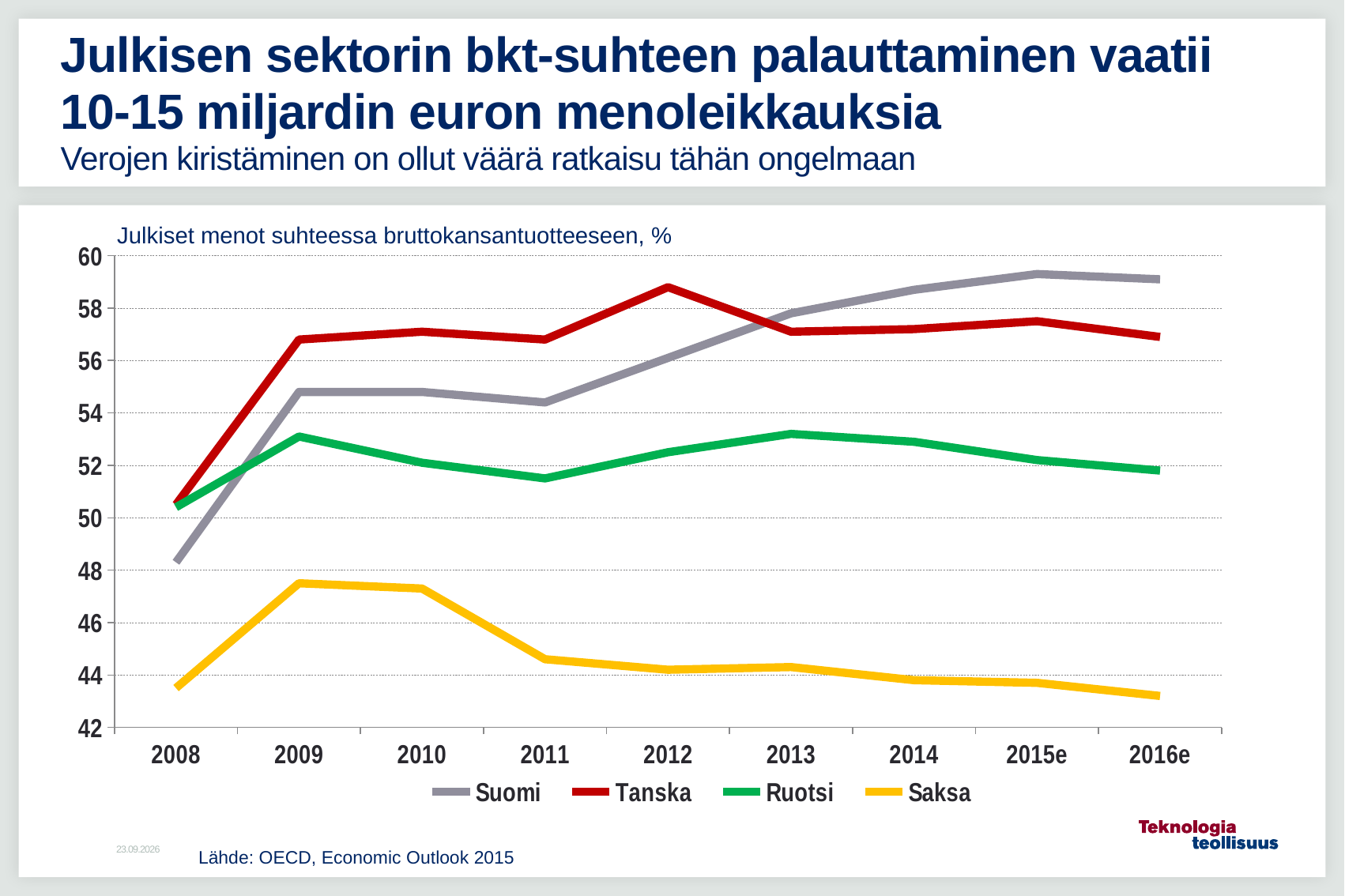
How many years are shown on the x axis? 9 Is the value for Tanska in 2012 greater or less than 58? greater Which is higher in 2016e, Suomi or Tanska? Suomi Which series has the lowest value in 2016e? Saksa What is the title of the chart? Julkiset menot suhteessa bruttokansantuotteeseen, % Does the Suomi line rise or fall from 2011 to 2015e? rise Is the value for Suomi in 2008 greater or less than 50? less Which series has the highest value in 2012? Tanska In which year is Suomi at its lowest value? 2008 How many series does the legend list? 4 What kind of chart is shown on the slide? line chart In which year does Saksa reach its highest value? 2009